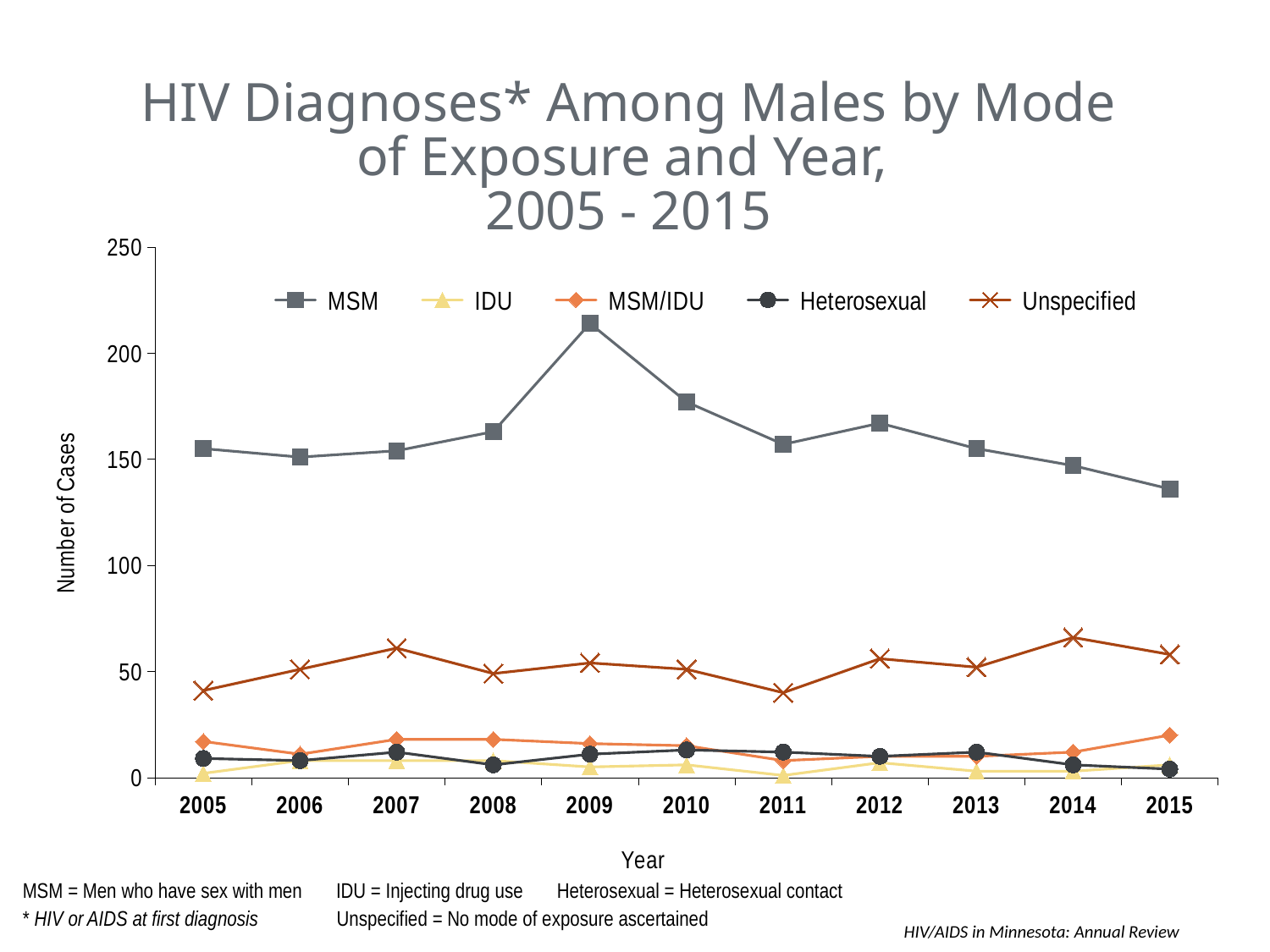
Which series has the highest values across all years? MSM In 2010, which series has the larger value, MSM or Unspecified? MSM How many series does the legend list? 5 Does the MSM series rise or fall from 2012 to 2015? fall What is the label on the y axis? Number of Cases How many years are plotted along the x axis? 11 What kind of chart is shown on the slide? line chart Is the Unspecified value for 2011 greater or less than 50? less Is the MSM value for 2009 greater or less than 200? greater In which year does the MSM series reach its highest value? 2009 In which year does the MSM series reach its lowest value? 2015 Is the MSM value for 2015 greater or less than 150? less